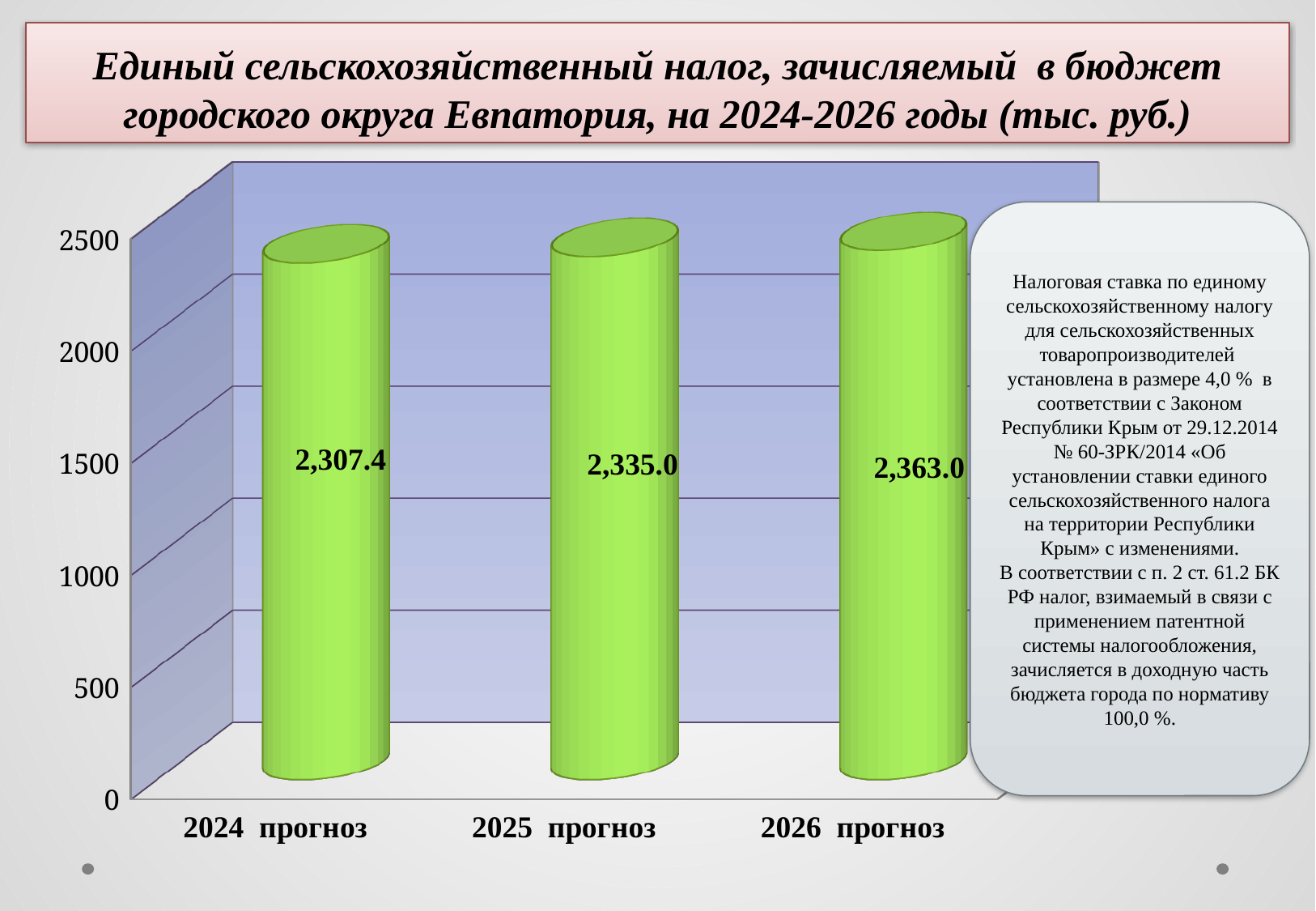
What kind of chart is shown on the slide? bar chart What is the value for 2024 прогноз? 2,307.4 What is the difference between the values for 2025 прогноз and 2024 прогноз? 27.6 Which category has the lowest value? 2024 прогноз What is the difference between the values for 2026 прогноз and 2024 прогноз? 55.6 Which is larger, the value for 2025 прогноз or the value for 2026 прогноз? 2026 прогноз Do the values rise or fall from 2024 прогноз to 2026 прогноз? rise What is the value for 2026 прогноз? 2,363.0 How many categories are shown on the x axis? 3 Is the value for 2024 прогноз greater or less than 2000? greater Which category has the highest value? 2026 прогноз What is the value for 2025 прогноз? 2,335.0